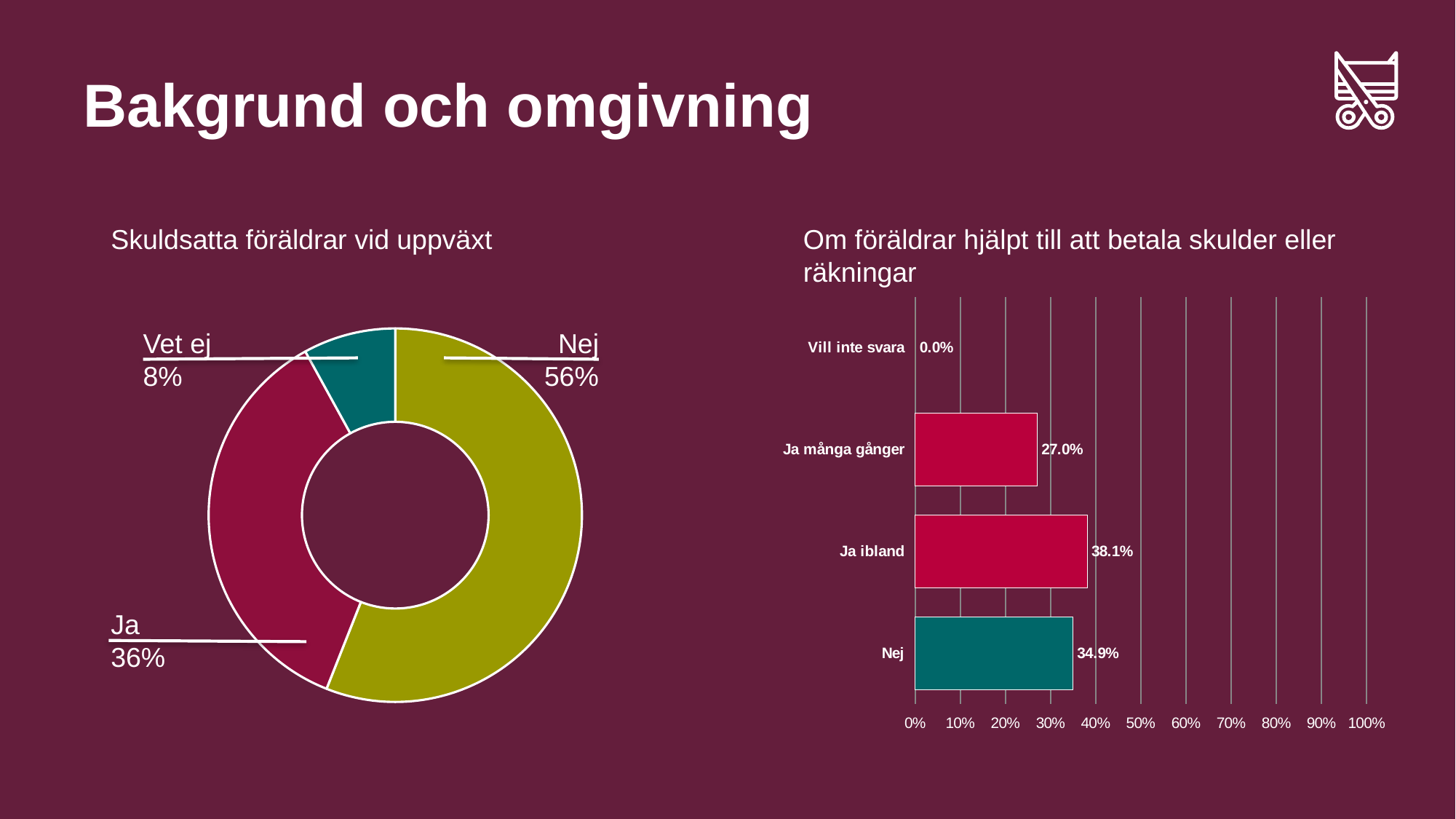
In the 'Om föräldrar hjälpt till att betala skulder eller räkningar' chart, which category has the highest value? Ja ibland In the 'Skuldsatta föräldrar vid uppväxt' chart, which category has the largest share? Nej In the 'Skuldsatta föräldrar vid uppväxt' chart, what share is labelled 'Nej'? 56% How many categories does the 'Om föräldrar hjälpt till att betala skulder eller räkningar' chart show? 4 In the 'Om föräldrar hjälpt till att betala skulder eller räkningar' chart, which is larger: 'Nej' or 'Ja många gånger'? Nej What kind of chart is 'Skuldsatta föräldrar vid uppväxt'? Pie chart (doughnut) In the 'Skuldsatta föräldrar vid uppväxt' chart, what share is labelled 'Vet ej'? 8% In the 'Skuldsatta föräldrar vid uppväxt' chart, what share is labelled 'Ja'? 36% In the 'Om föräldrar hjälpt till att betala skulder eller räkningar' chart, what is the value for 'Ja många gånger'? 27.0% In the 'Om föräldrar hjälpt till att betala skulder eller räkningar' chart, what is the value for 'Ja ibland'? 38.1% In the 'Skuldsatta föräldrar vid uppväxt' chart, how many percentage points larger is 'Nej' than 'Ja'? 20 In the 'Skuldsatta föräldrar vid uppväxt' chart, which category has the smallest share? Vet ej